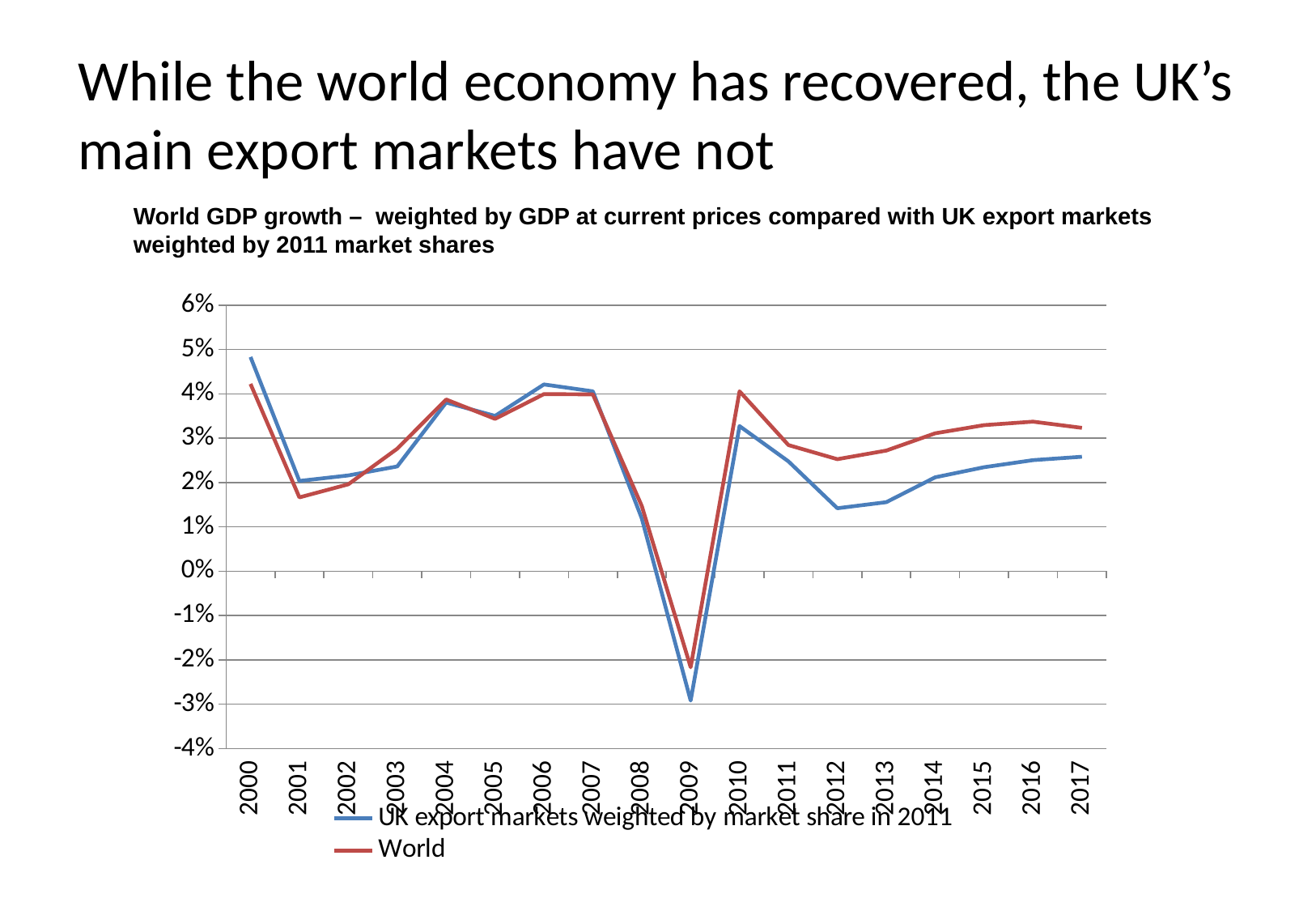
Does the UK export markets series rise or fall from 2012 to 2017? rise In which year does the UK export markets series reach its highest value? 2000 In which year does the UK export markets series reach its lowest value? 2009 How many years are plotted along the x axis? 18 Is the value for the World series in 2010 greater or less than 3%? greater Is the value for the UK export markets series in 2012 greater or less than 2%? less Is the value for the UK export markets series in 2009 greater or less than -2%? less In which year does the World series reach its lowest value? 2009 Which colour is used for the World series? red What kind of chart is shown on the slide? line chart How many series does the legend list? 2 In 2012, which series has the higher value, World or UK export markets? World